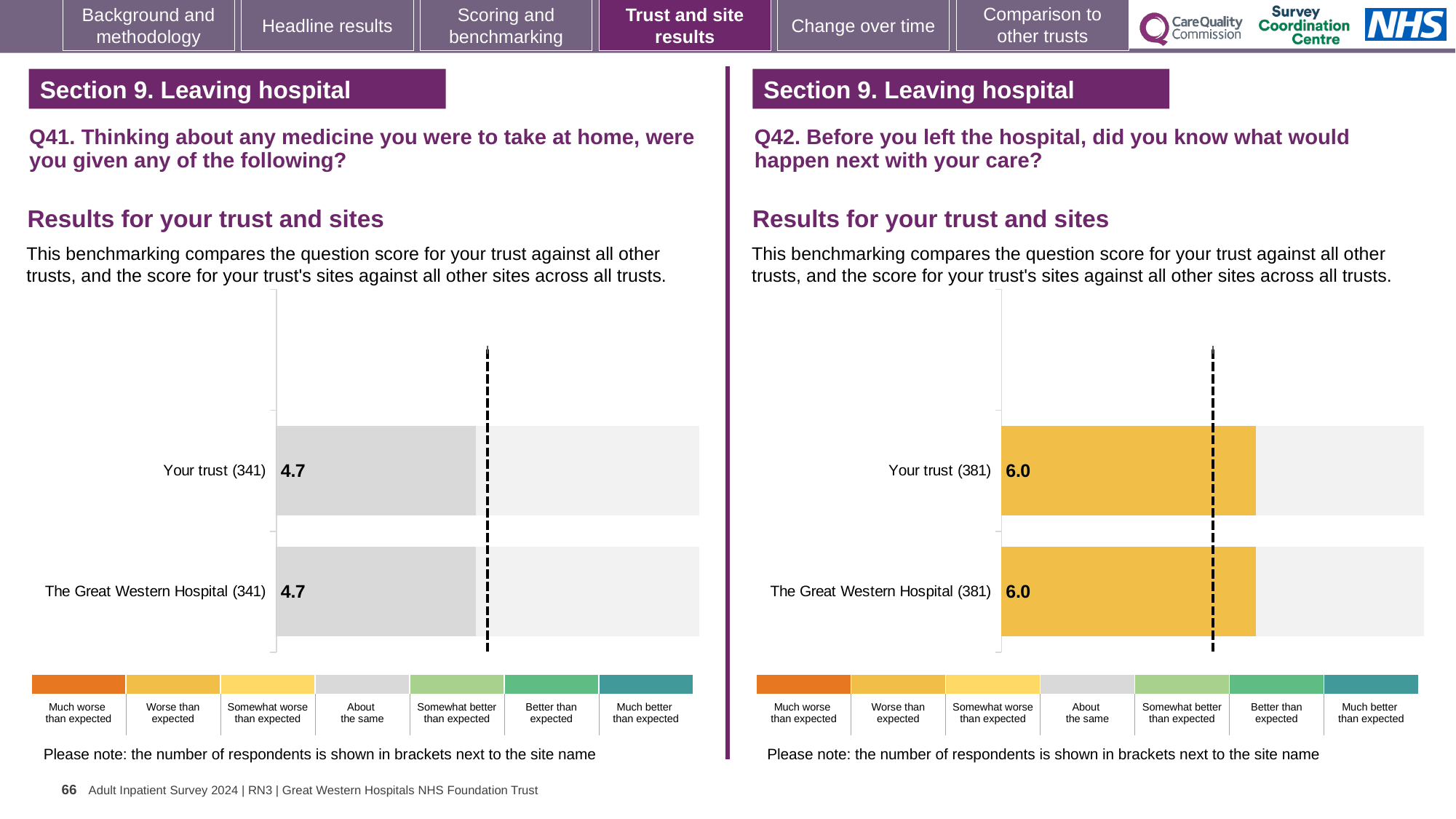
In the Q41 chart on the left, which benchmark category does the grey colour of the bars correspond to in the key? About the same In the Q41 chart on the left, how many respondents are shown in brackets next to Your trust? 341 What kind of chart is used in the Q41 chart on the left? Bar chart In the Q42 chart on the right, which benchmark category does the yellow-orange colour of the bars correspond to in the key? Worse than expected How many bars are plotted in the Q41 chart on the left? 2 In the Q42 chart on the right, what is the score for Your trust? 6.0 In the Q42 chart on the right, how many respondents are shown in brackets next to The Great Western Hospital? 381 How many bars are plotted in the Q42 chart on the right? 2 In the Q42 chart on the right, what is the difference between the score for Your trust and the score for The Great Western Hospital? 0.0 In the Q41 chart on the left, what is the score for The Great Western Hospital? 4.7 In the Q41 chart on the left, what is the score for Your trust? 4.7 In the Q42 chart on the right, what is the score for The Great Western Hospital? 6.0